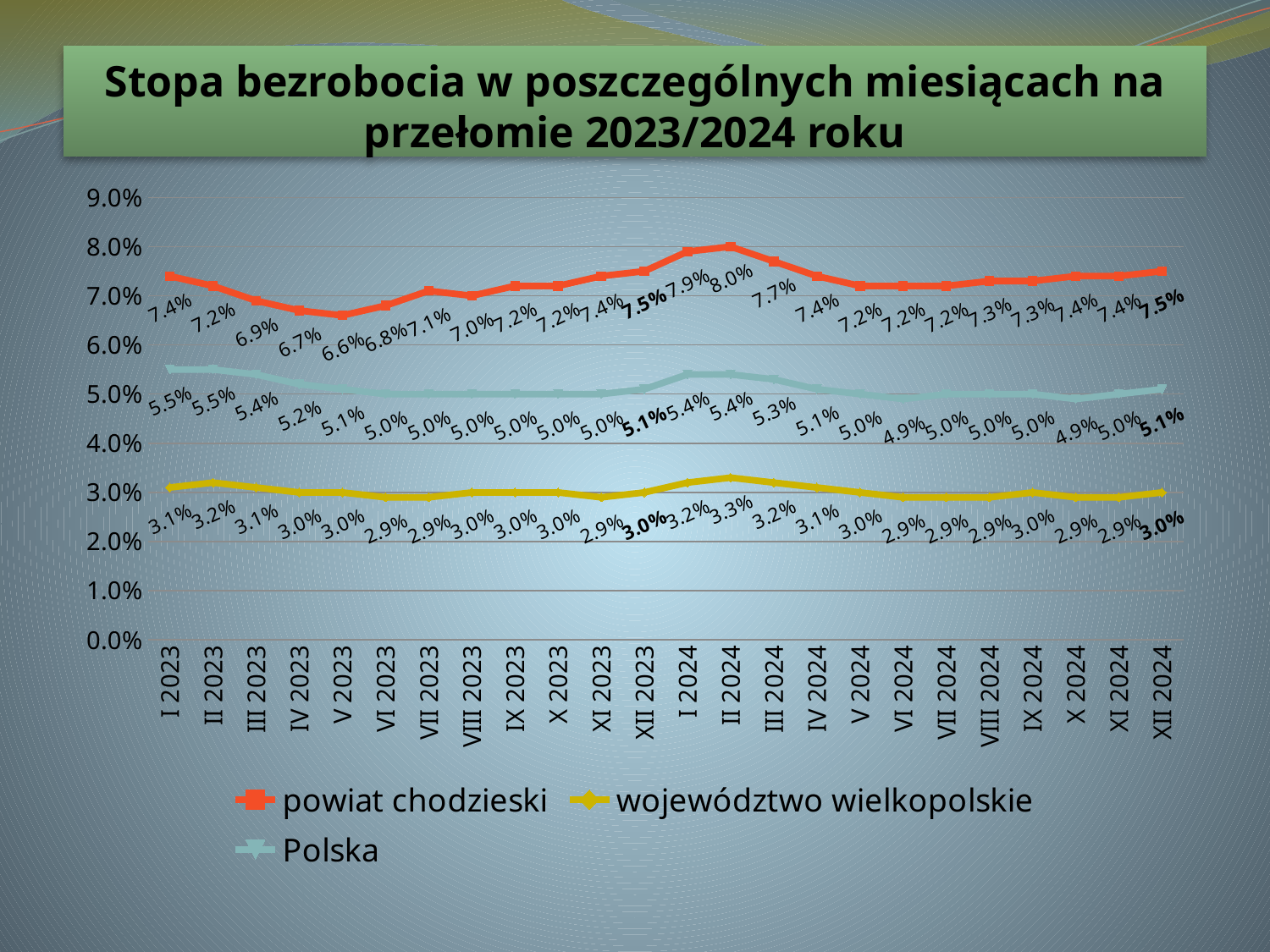
Which series is drawn in yellow? województwo wielkopolskie What is the unemployment rate for powiat chodzieski in II 2024? 8.0% What kind of chart is shown on the slide? line chart In which month does powiat chodzieski have its lowest value? V 2023 Is the value for powiat chodzieski in V 2023 greater or less than 7.0%? less Which series has the highest value in XII 2024? powiat chodzieski How many months are plotted along the x axis? 24 What is the value for Polska in I 2023? 5.5% In which month does powiat chodzieski reach its highest value? II 2024 How many series does the legend list? 3 What is the difference between powiat chodzieski and Polska in II 2024? 2.6 percentage points What is the value for województwo wielkopolskie in II 2024? 3.3%